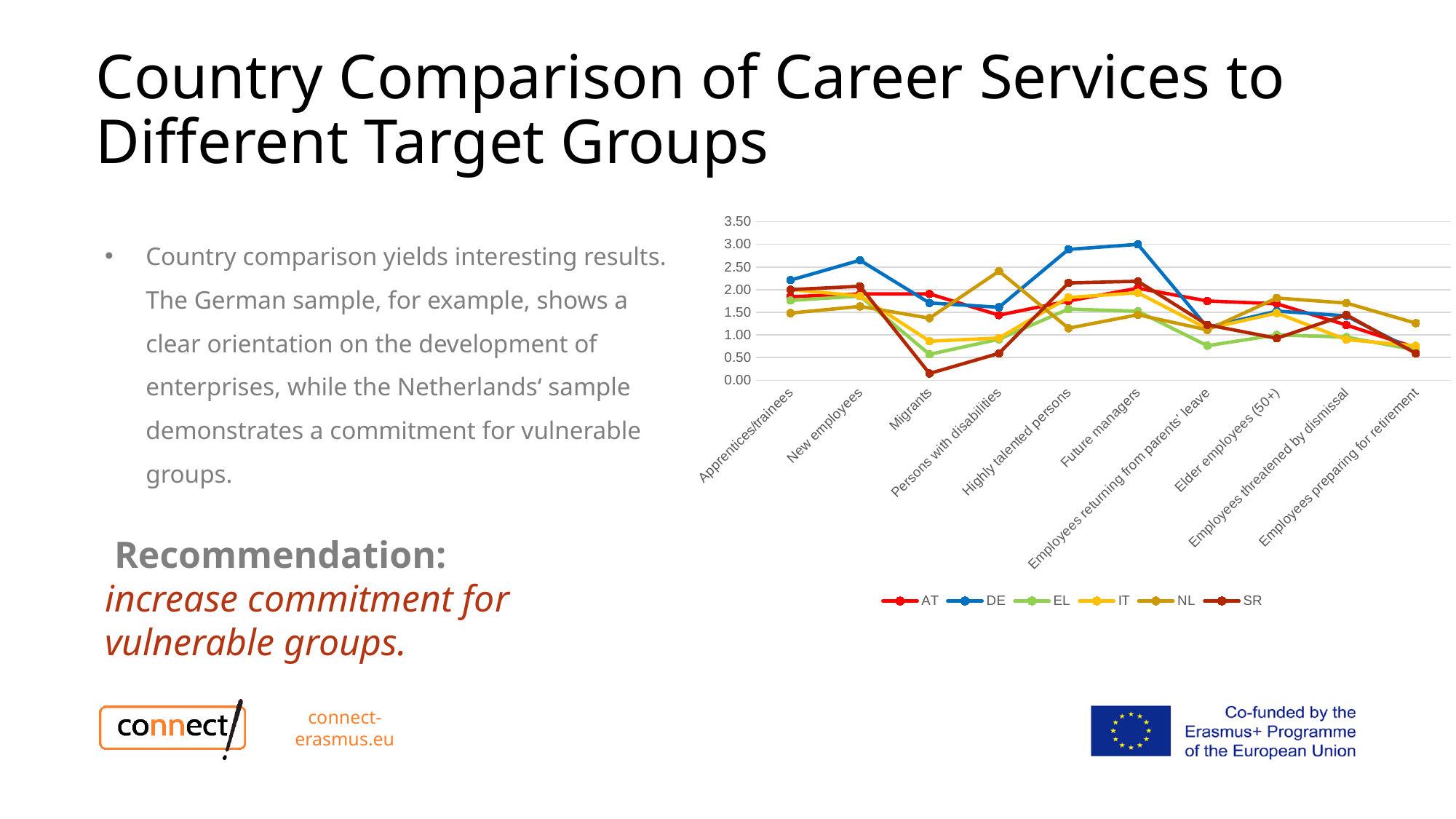
Is the value for SR at Migrants greater or less than 0.50? less Which series has the highest value for New employees? DE For Employees returning from parents' leave, which is larger: the value for DE or the value for EL? DE What kind of chart is shown on the slide? line chart Is the value for DE at Future managers greater or less than 2.50? greater Which series has the lowest value for Migrants? SR How many series does the chart legend list? 6 Is the value for NL at Persons with disabilities greater or less than 2.00? greater How many target-group categories are plotted along the x axis? 10 Which series has the highest value for Persons with disabilities? NL Which colour is used for the AT series in the legend? red Which series has the highest value for Employees preparing for retirement? NL